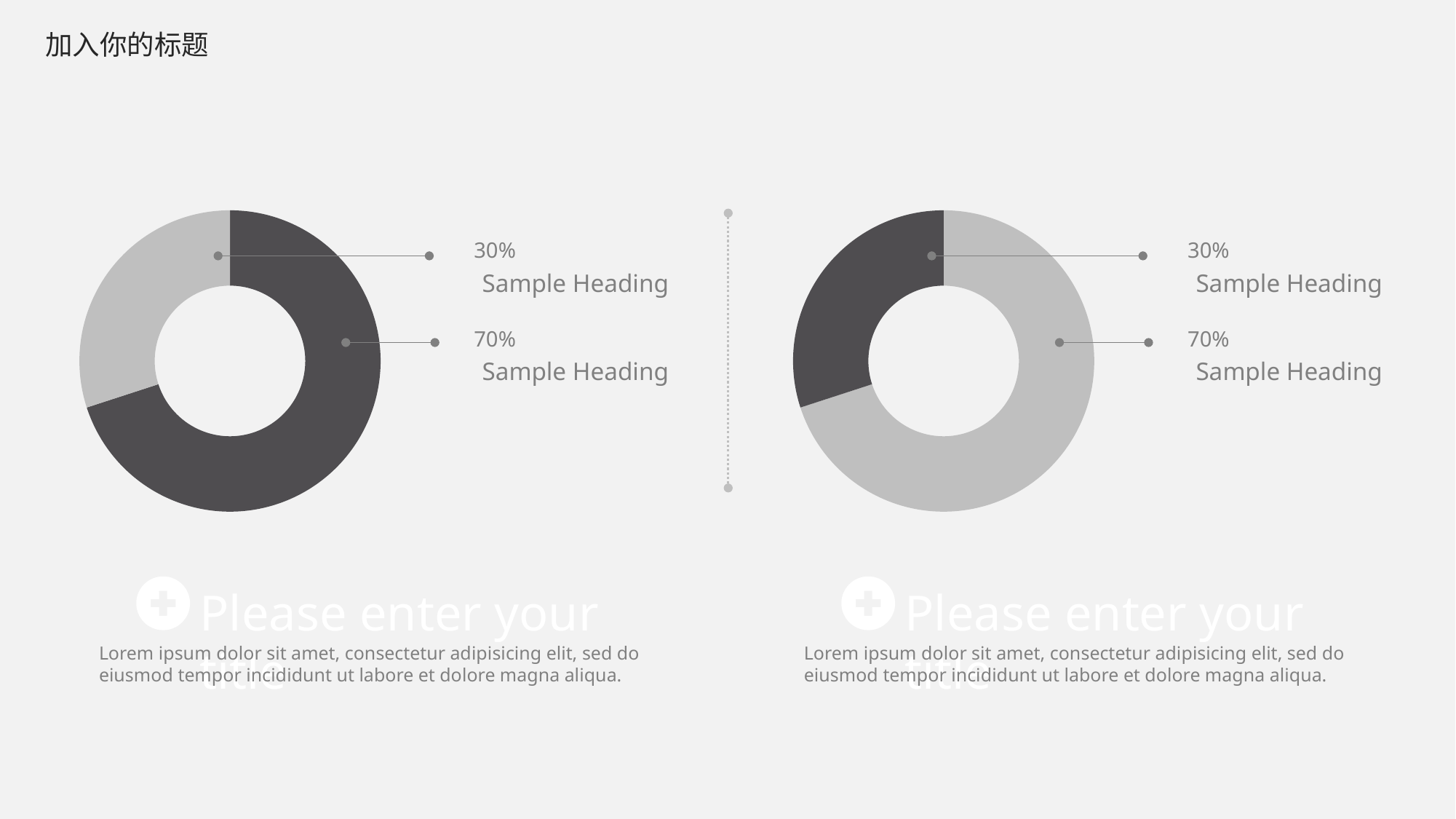
In the left donut chart, what share does the light grey slice represent? 30% In the left donut chart, what share does the dark grey slice represent? 70% In the right donut chart, what share does the dark grey slice represent? 30% In the right donut chart, which slice is the smallest? The dark grey slice (30%) In the left donut chart, how many slices are there? 2 What kind of chart is shown on the left side of the slide? Donut chart What kind of chart is shown on the right side of the slide? Donut chart What text label is attached to each slice of the right donut chart? Sample Heading In the right donut chart, how many slices are there? 2 In the left donut chart, what is the difference in percentage points between the two slices? 40 percentage points In the left donut chart, which slice is larger, the dark grey one or the light grey one? The dark grey one